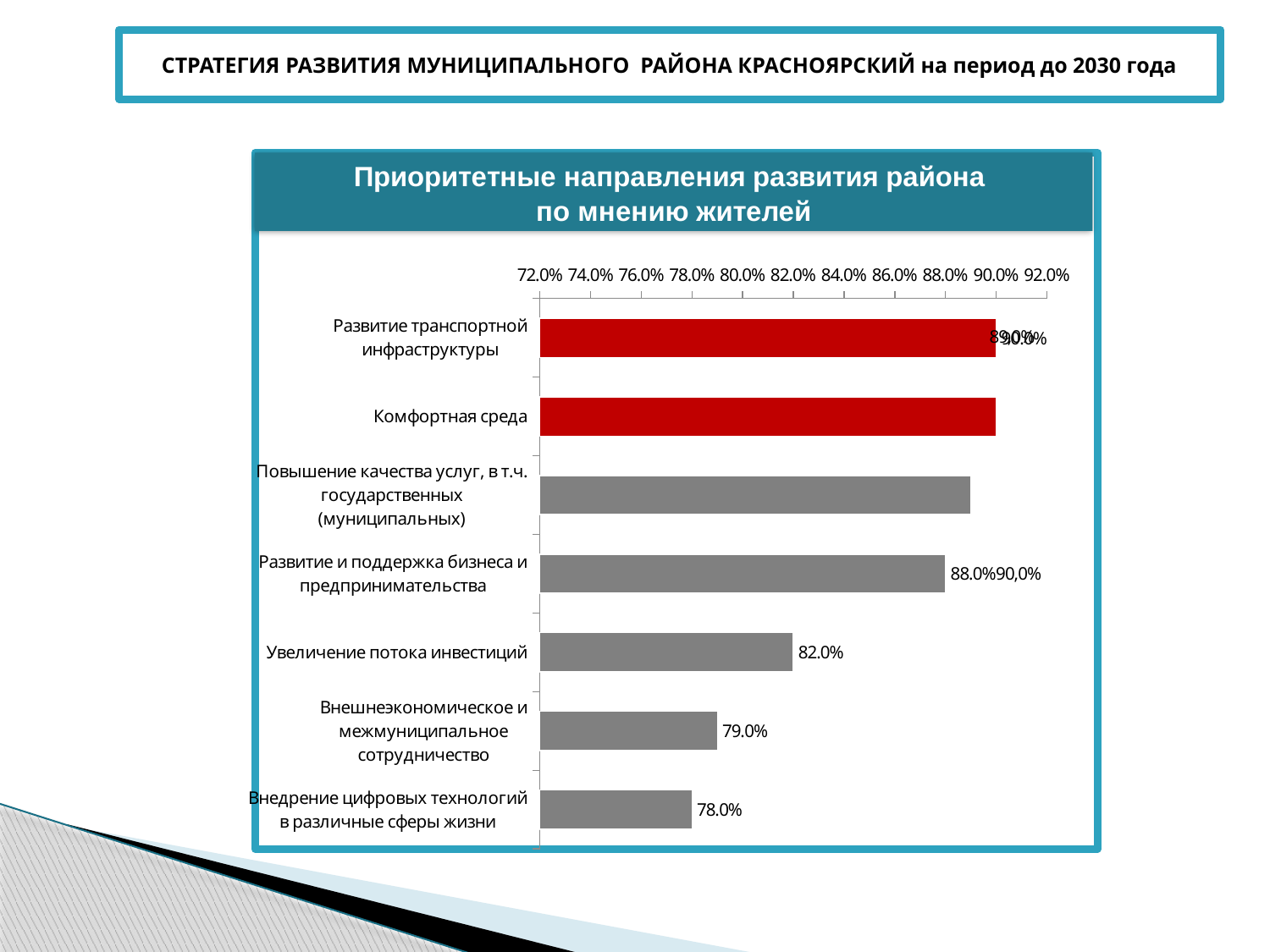
Which category has the lowest value? Внедрение цифровых технологий в различные сферы жизни What is the title of the chart? Приоритетные направления развития района по мнению жителей How many categories (priority directions) are shown in the chart? 7 Which is larger: the value for "Увеличение потока инвестиций" or for "Внешнеэкономическое и межмуниципальное сотрудничество"? Увеличение потока инвестиций Is the value for "Комфортная среда" greater or less than 86.0%? greater What is the value for "Внешнеэкономическое и межмуниципальное сотрудничество"? 79.0% Which two categories are highlighted with red bars? Развитие транспортной инфраструктуры and Комфортная среда What is the value for "Увеличение потока инвестиций"? 82.0% What is the difference between the values for "Увеличение потока инвестиций" and "Внедрение цифровых технологий в различные сферы жизни"? 4.0% What type of chart is shown on the slide? bar chart Is the value for "Повышение качества услуг, в т.ч. государственных (муниципальных)" greater or less than 84.0%? greater What is the value for "Внедрение цифровых технологий в различные сферы жизни"? 78.0%